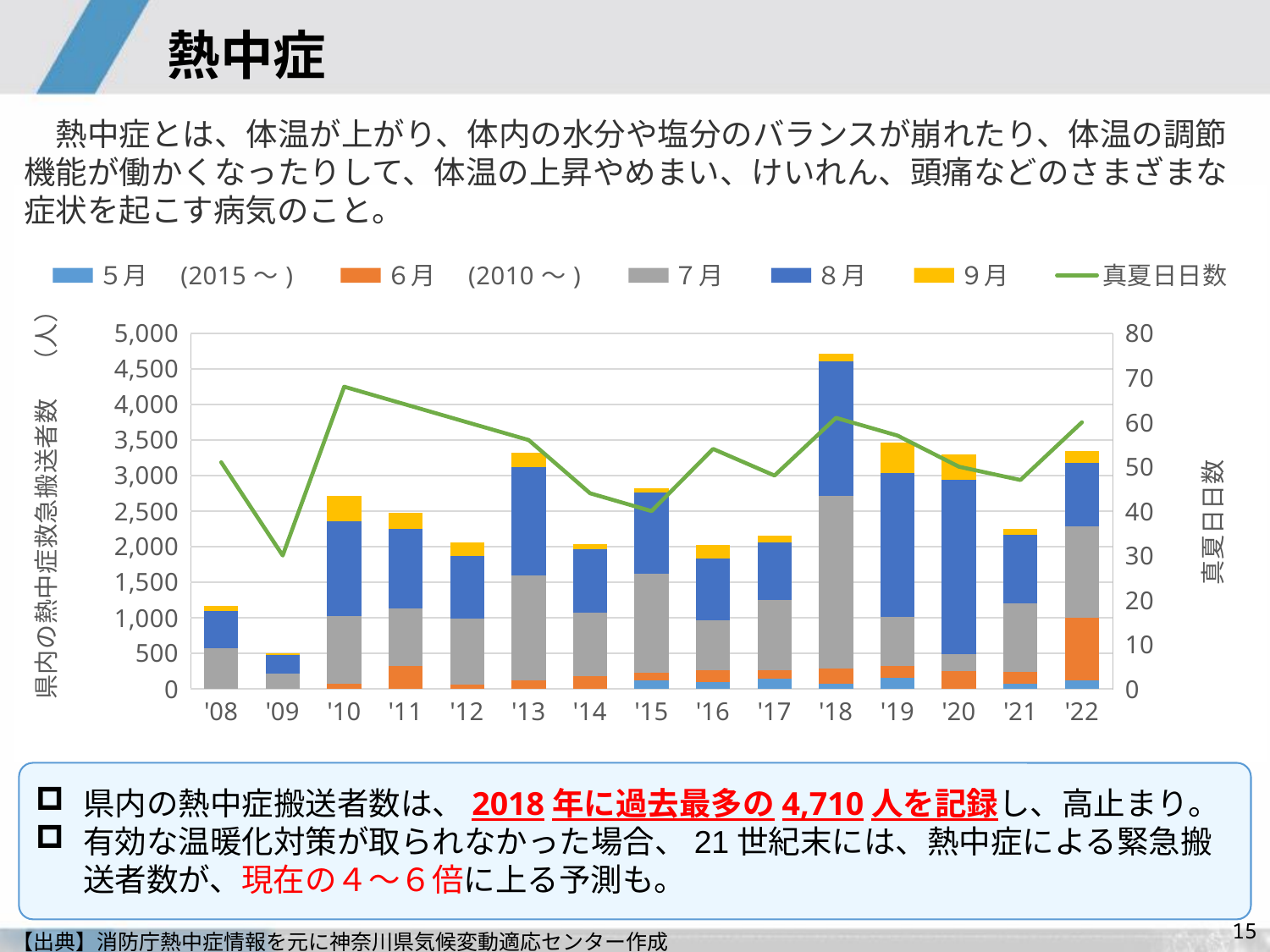
Is the total stacked bar value for '09 greater or less than 1,000? less In which year does the 真夏日日数 line reach its lowest point? '09 What is the label of the right-hand vertical axis? 真夏日日数 Which year has the shortest stacked bar for 県内の熱中症救急搬送者数? '09 Is the 真夏日日数 value for '10 greater or less than 60? greater In which year does the 真夏日日数 line reach its highest point? '10 How many series does the chart legend list? 6 Is the total stacked bar value for '18 greater or less than 4,500? greater How many years (categories) are shown on the x axis of the chart? 15 Which year has the larger total stacked bar, '13 or '14? '13 Which year has the tallest stacked bar for 県内の熱中症救急搬送者数? '18 What kind of chart is shown on the slide? A combination chart of stacked bars and a line